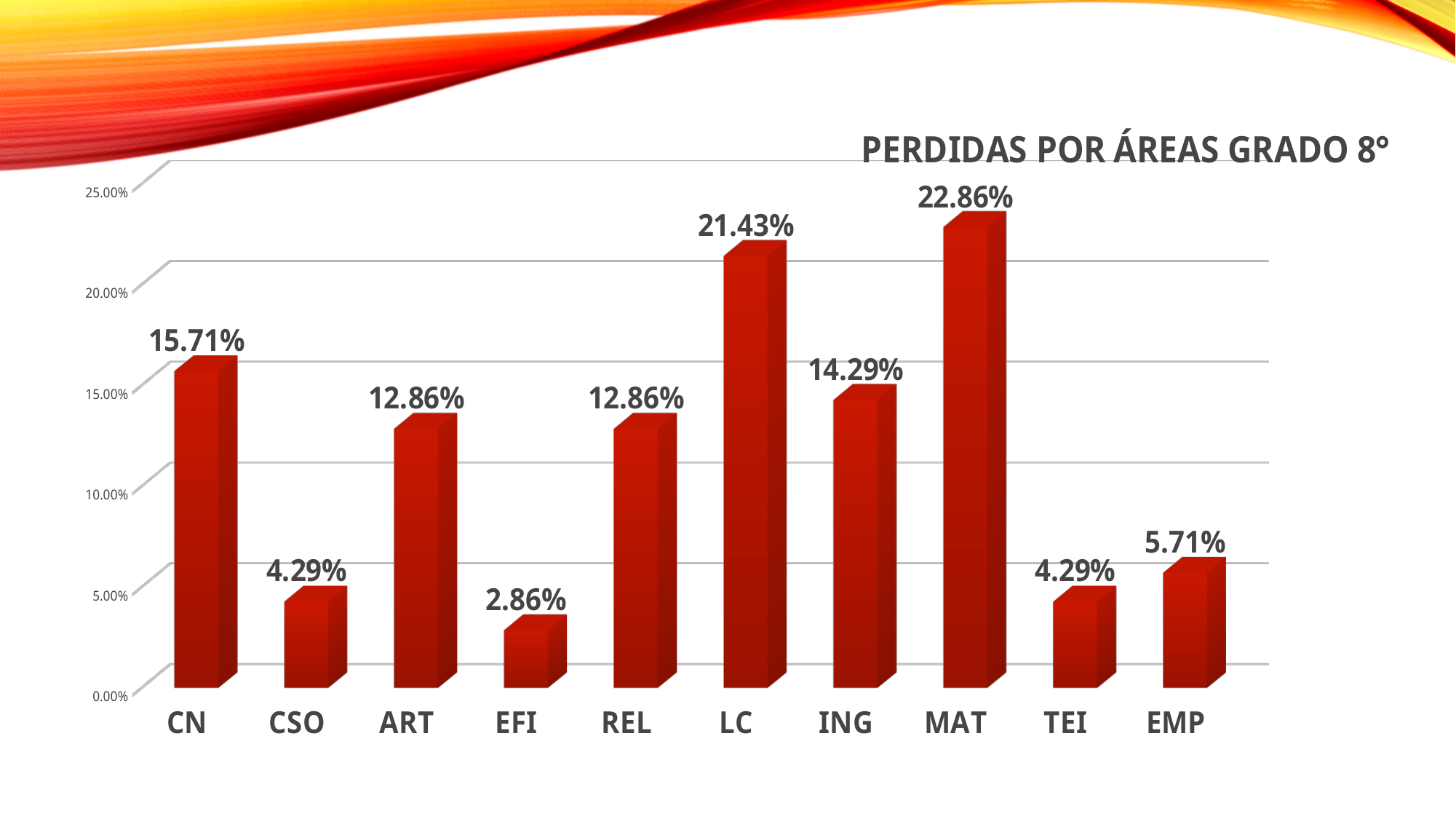
What is the difference between the values for CN and ING? 1.42% What is the difference between the values for MAT and LC? 1.43% What is the value for CN? 15.71% What is the title of the chart? PERDIDAS POR ÁREAS GRADO 8° What is the value for MAT? 22.86% Which area has the highest value? MAT Is the value for EMP greater or less than 10.00%? less Which area has the lowest value? EFI Which is larger, the value for LC or the value for ING? LC What is the value for EFI? 2.86% How many areas are shown on the x axis? 10 What kind of chart is shown on the slide? bar chart